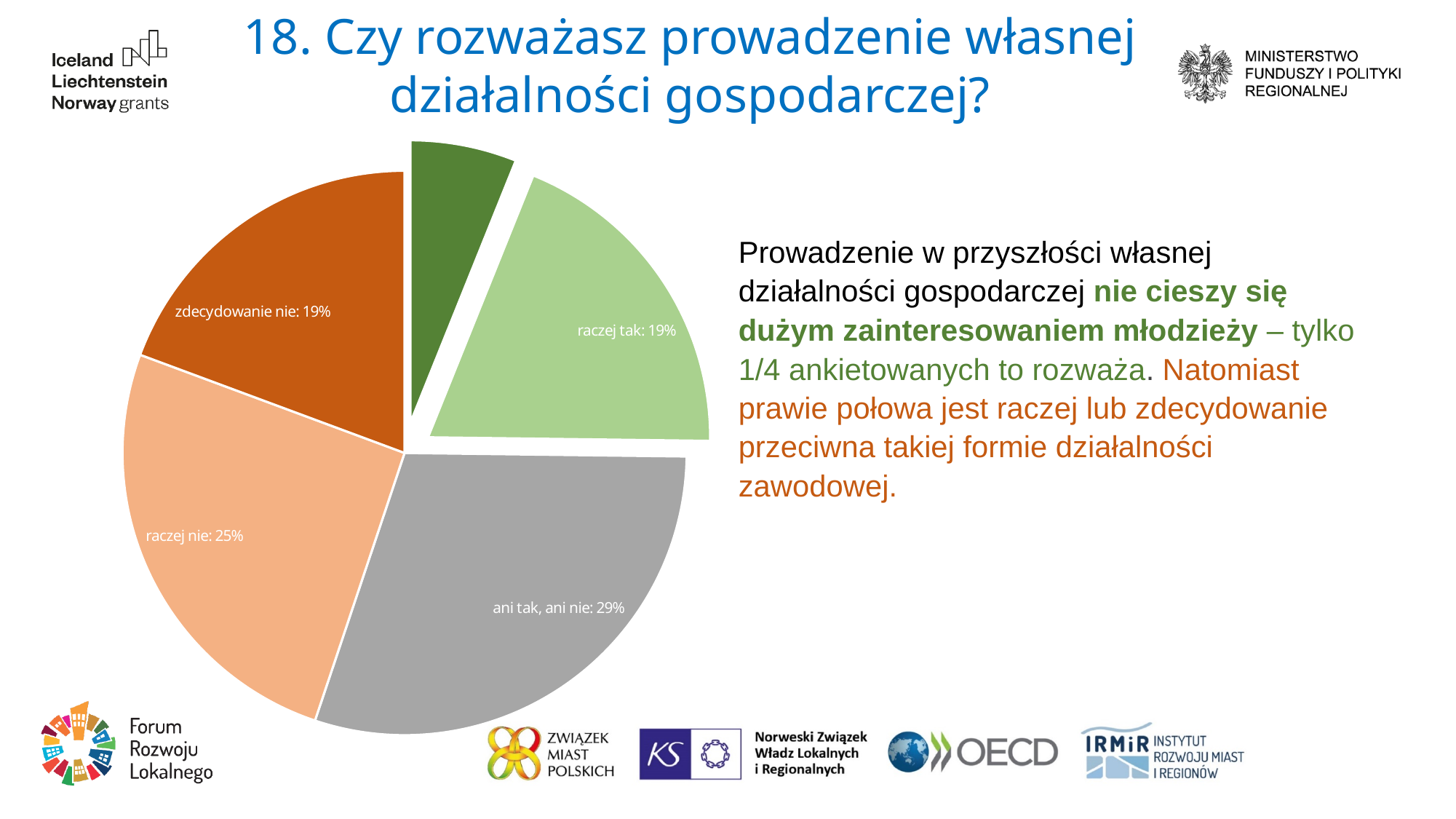
What value is shown for the "raczej tak" slice? 19% What type of chart is shown on the slide? pie chart What is the combined share of "raczej nie" and "zdecydowanie nie"? 44% What value is shown for the "zdecydowanie nie" slice? 19% Which labelled slice of the pie chart has the largest share? ani tak, ani nie What is the difference in percentage points between "raczej nie" and "zdecydowanie nie"? 6 What share of the pie chart is labelled "ani tak, ani nie"? 29% What colour is the "ani tak, ani nie" slice of the pie chart? grey How many slices does the pie chart have? 5 By how many percentage points does "ani tak, ani nie" exceed "raczej nie"? 4 Which is larger: the share for "raczej nie" or the share for "raczej tak"? raczej nie What percentage of respondents answered "raczej nie" in the pie chart? 25%